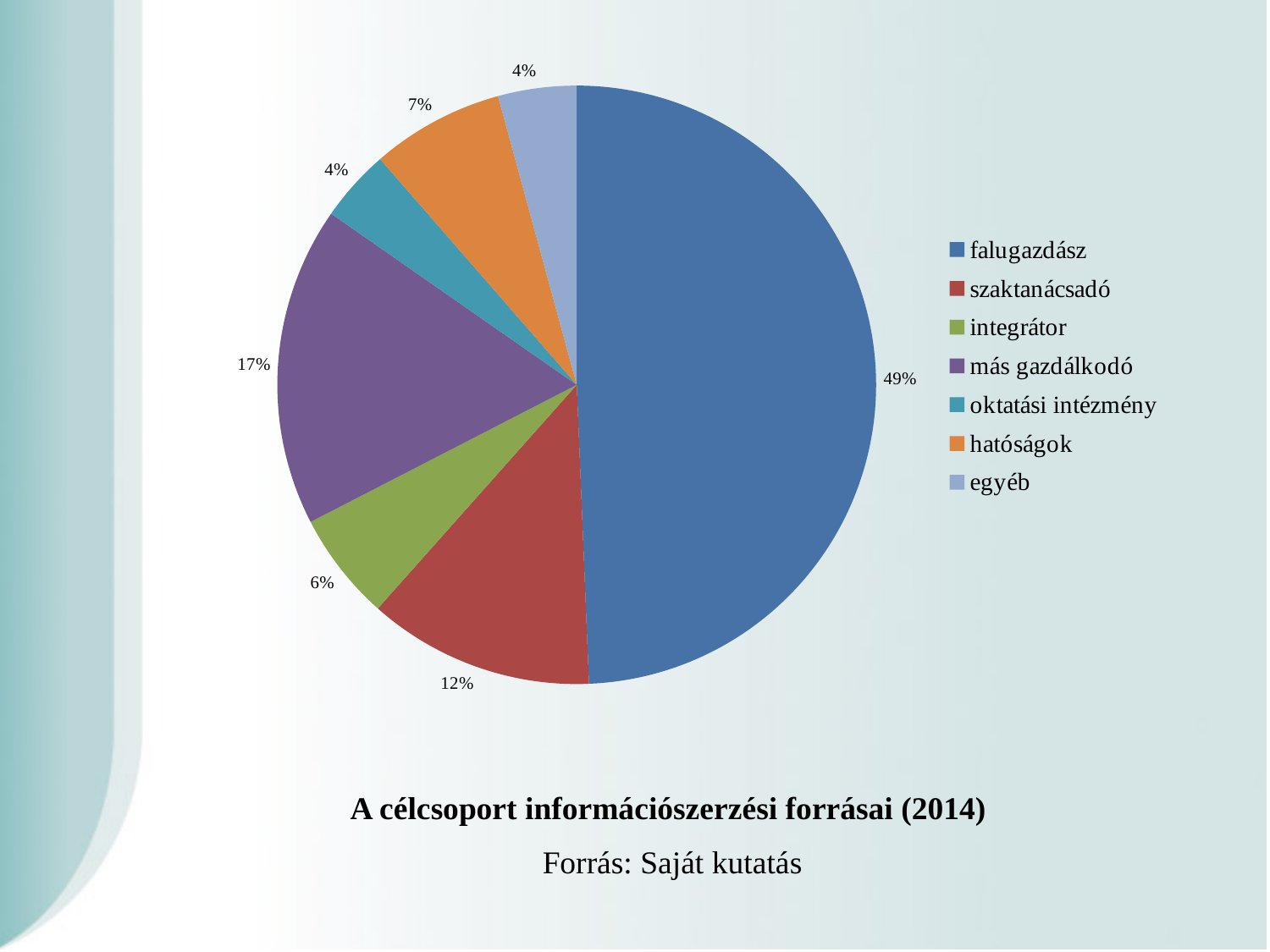
What kind of chart is shown on the slide? pie chart What share of the pie does hatóságok have? 7% What share of the pie does szaktanácsadó have? 12% What is the difference in percentage points between the falugazdász slice and the más gazdálkodó slice? 32 What share of the pie does más gazdálkodó have? 17% What is the title of the chart shown on the slide? A célcsoport információszerzési forrásai (2014) How many slices does the pie chart have? 7 Which category has the largest slice of the pie? falugazdász What share of the pie does falugazdász have? 49% Which is larger, the slice for szaktanácsadó or the slice for más gazdálkodó? más gazdálkodó What is the difference in percentage points between the hatóságok slice and the oktatási intézmény slice? 3 What share of the pie does integrátor have? 6%